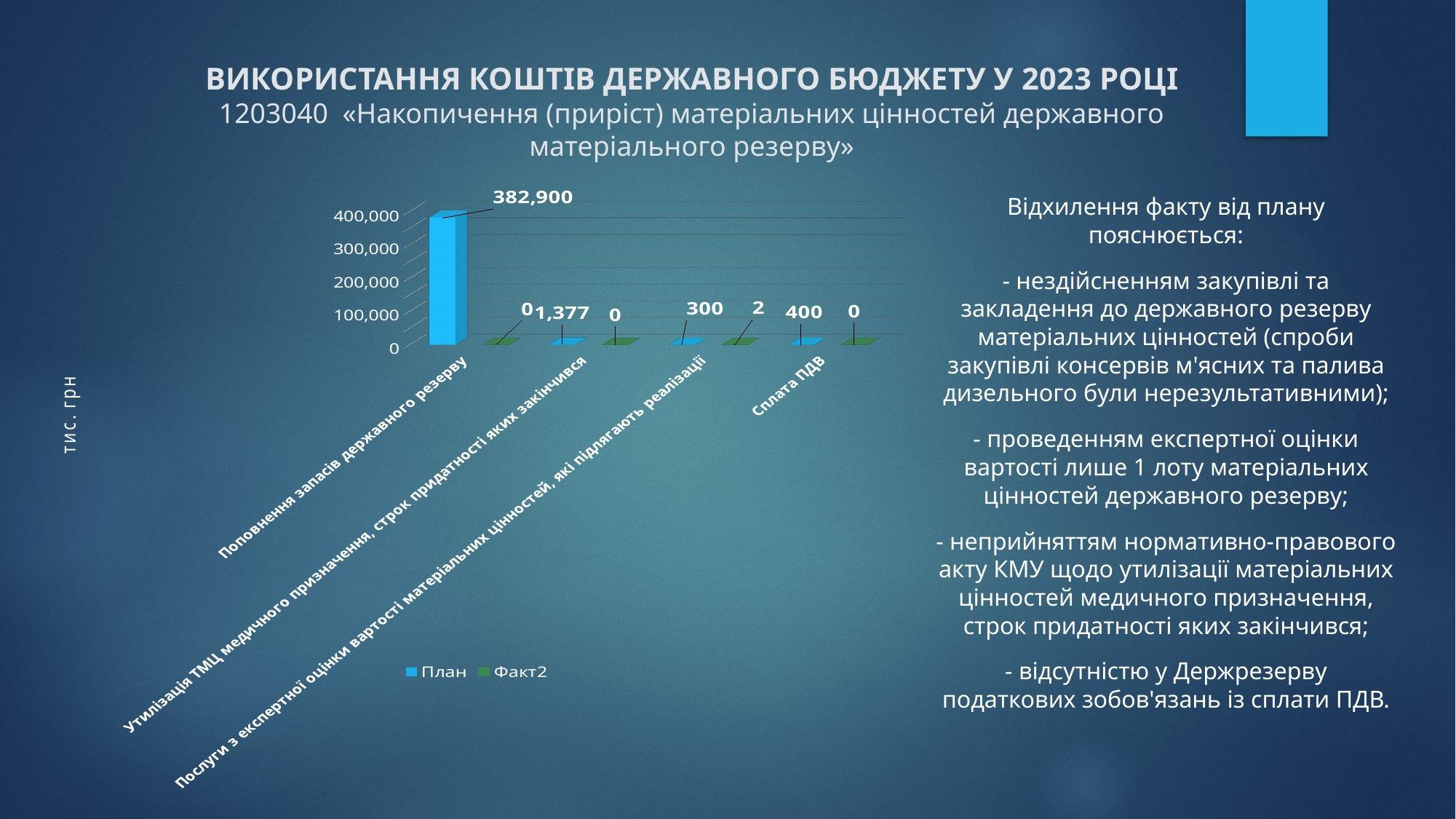
How many series does the chart legend list? 2 What is the difference between the План and Факт2 values for "Послуги з експертної оцінки вартості матеріальних цінностей, які підлягають реалізації"? 298 What is the План value for "Утилізація ТМЦ медичного призначення, строк придатності яких закінчився"? 1,377 What is the План value for "Поповнення запасів державного резерву"? 382,900 What is the difference between the План and Факт2 values for "Сплата ПДВ"? 400 What type of chart is shown on the slide? Bar chart Which category has the highest План value? Поповнення запасів державного резерву What is the Факт2 value for "Послуги з експертної оцінки вартості матеріальних цінностей, які підлягають реалізації"? 2 What is the План value for "Сплата ПДВ"? 400 Which is larger: the План value for "Сплата ПДВ" or the План value for "Утилізація ТМЦ медичного призначення, строк придатності яких закінчився"? Утилізація ТМЦ медичного призначення, строк придатності яких закінчився Which category has the lowest План value? Послуги з експертної оцінки вартості матеріальних цінностей, які підлягають реалізації How many categories are shown on the x axis of the chart? 4